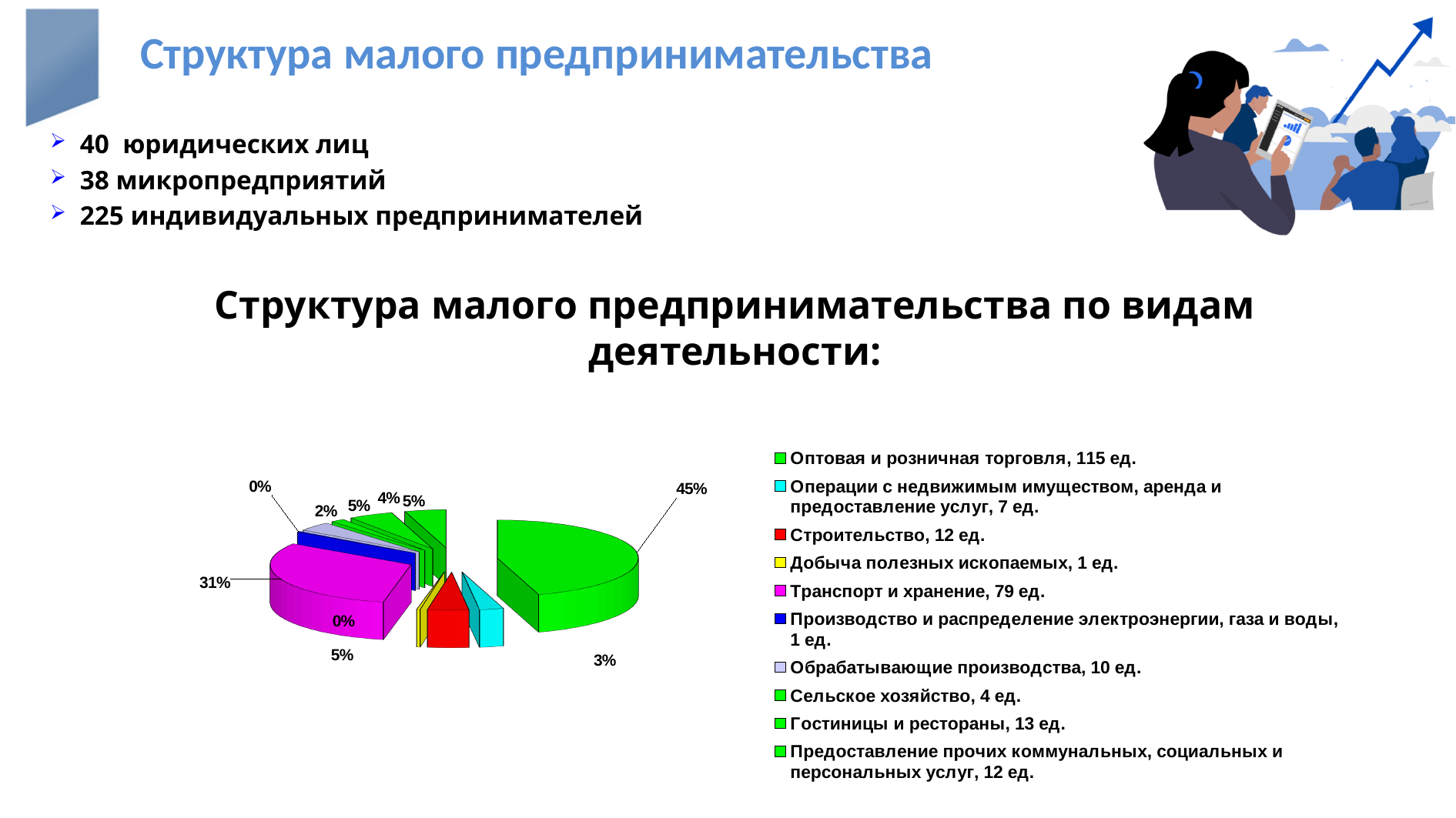
What share of the pie does Оптовая и розничная торговля take? 45% How many units are listed for Оптовая и розничная торговля in the legend? 115 ед. What kind of chart is shown on the slide? pie chart How many units are listed for Транспорт и хранение? 79 ед. What share of the pie does Транспорт и хранение take? 31% What is the title of the chart on the slide? Структура малого предпринимательства по видам деятельности: What is the difference in units between Оптовая и розничная торговля and Транспорт и хранение? 36 ед. Which has more units: Строительство or Сельское хозяйство? Строительство How many categories does the pie chart's legend list? 10 How many units are listed for Гостиницы и рестораны? 13 ед. Which category has the largest number of units in the pie chart? Оптовая и розничная торговля How many units are listed for Обрабатывающие производства? 10 ед.